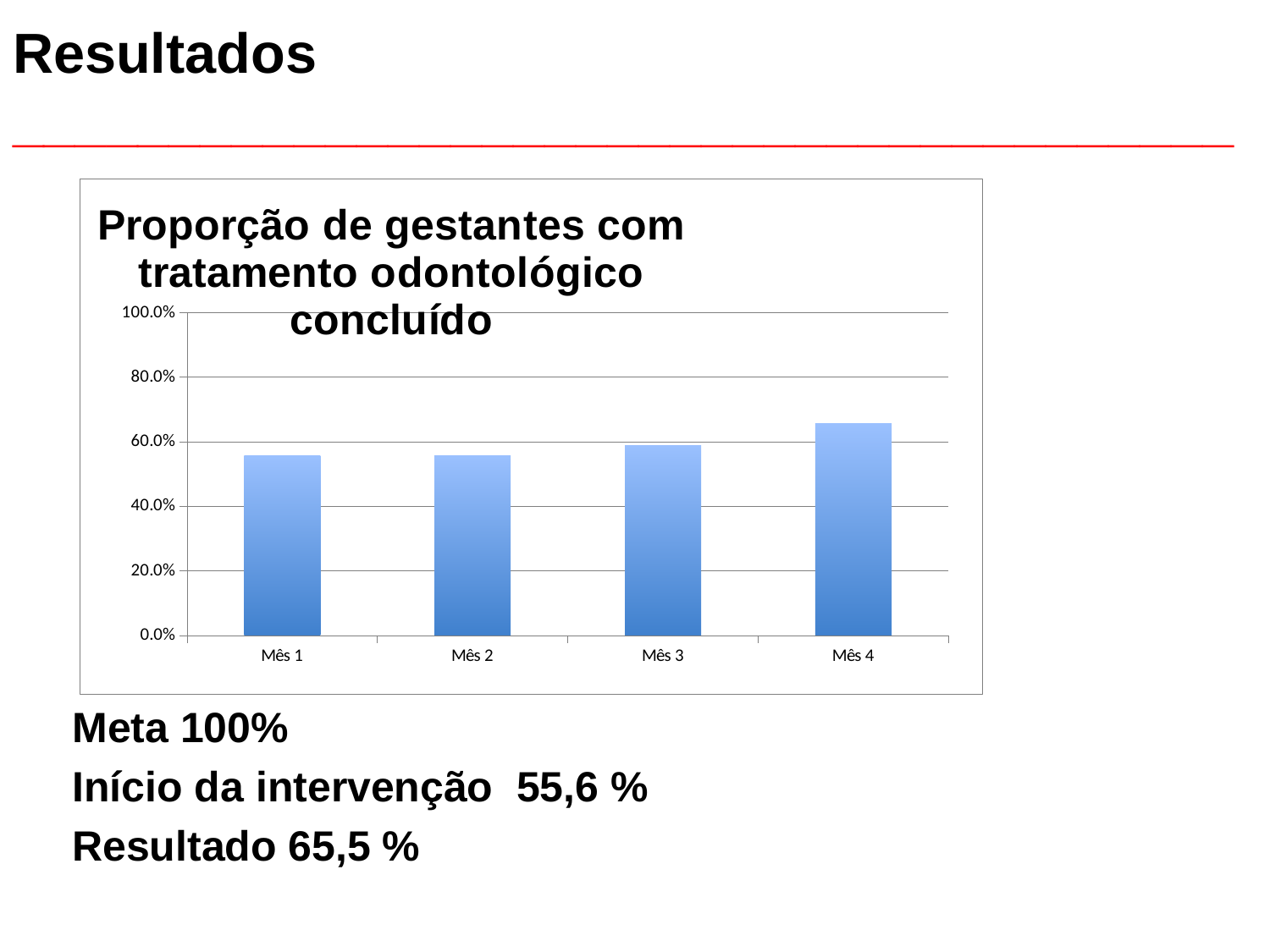
What is the highest value shown on the y axis? 100.0% Which month has the highest proportion of pregnant women with completed dental treatment? Mês 4 Which is larger, the value for Mês 4 or the value for Mês 1? Mês 4 Is the value for Mês 4 greater or less than 80.0%? less Do the values rise or fall from Mês 1 to Mês 4? rise Is the value for Mês 1 greater or less than 60.0%? less What kind of chart is shown on the slide? bar chart Which is larger, the value for Mês 3 or the value for Mês 2? Mês 3 How many months (categories) are plotted on the x axis? 4 Is the value for Mês 2 greater or less than 40.0%? greater What is the title of the chart? Proporção de gestantes com tratamento odontológico concluído